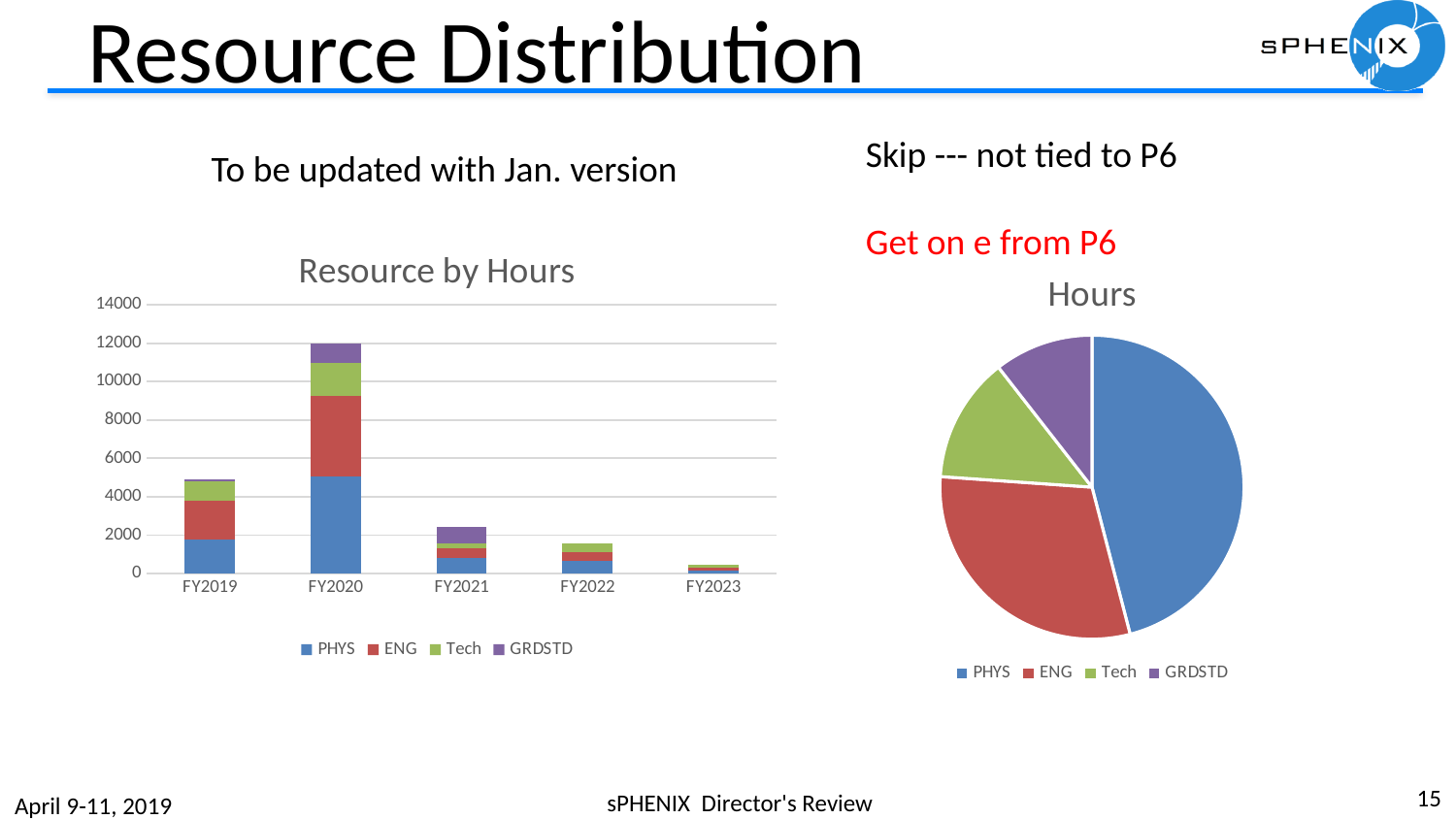
How many series does the legend of the "Resource by Hours" chart list? 4 In the "Resource by Hours" chart, which fiscal year has the highest total hours? FY2020 In the "Resource by Hours" chart, which fiscal year has the lowest total hours? FY2023 In the "Resource by Hours" chart, how many fiscal years are shown on the x axis? 5 In the "Resource by Hours" chart, is the total for FY2020 greater or less than 10000? greater What kind of chart is the "Resource by Hours" chart? stacked bar chart In the "Hours" pie chart, which slice is larger, PHYS or ENG? PHYS In the "Resource by Hours" chart, is the total for FY2019 greater or less than 4000? greater In the "Resource by Hours" chart, is the total for FY2022 greater or less than 2000? less What kind of chart is the "Hours" chart? pie chart In the "Hours" pie chart, which category has the largest slice? PHYS In the "Resource by Hours" chart, do the total hours rise or fall from FY2020 to FY2023? fall